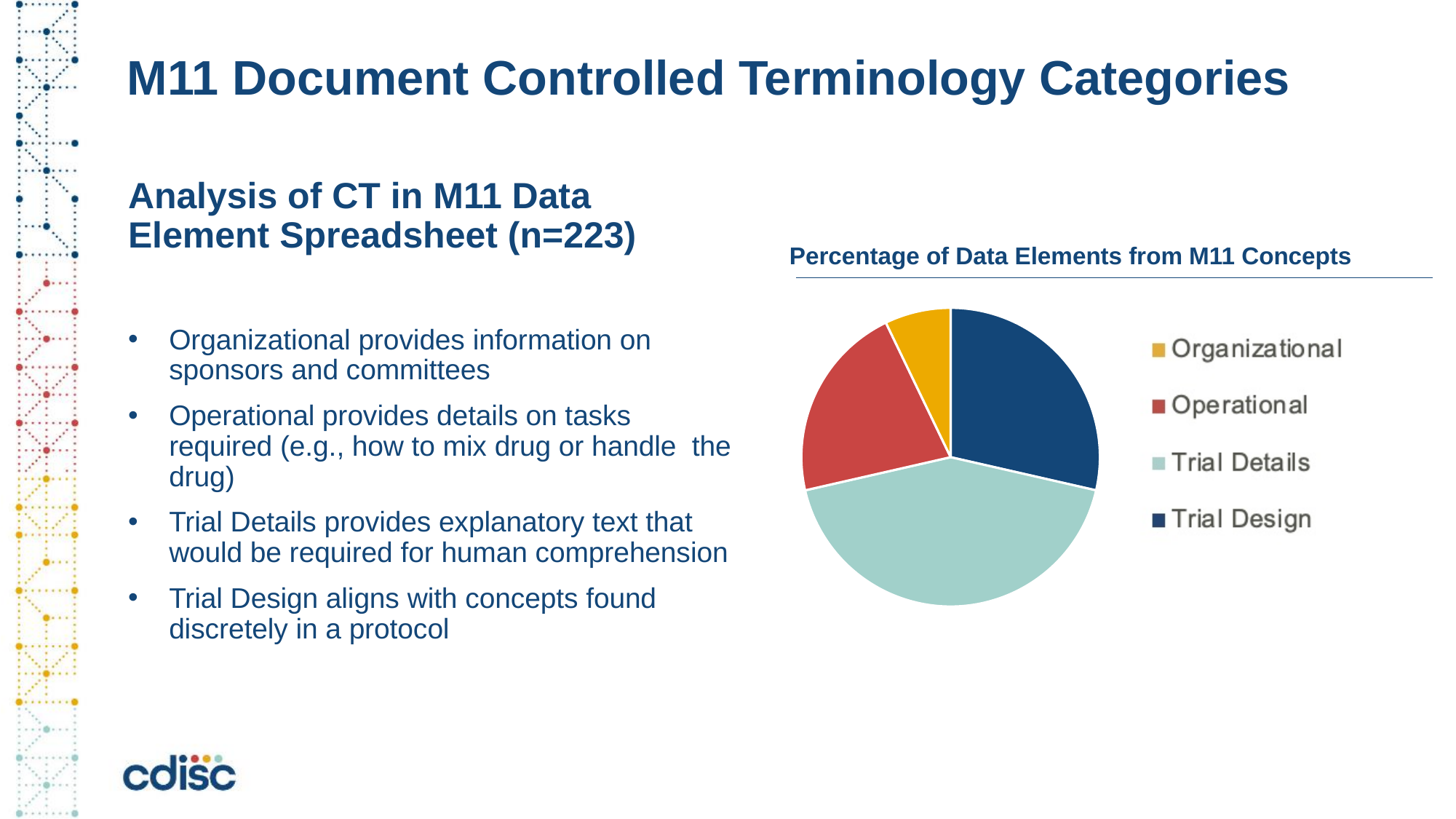
Which category has the largest slice of the pie? Trial Details How many entries does the chart's legend list? 4 What is the title of the chart? Percentage of Data Elements from M11 Concepts Which category is shown in yellow in the pie chart? Organizational Which slice is larger, Trial Details or Trial Design? Trial Details Which category has the smallest slice of the pie? Organizational Which slice is larger, Trial Design or Operational? Trial Design How many categories does the pie chart show? 4 Which slice is larger, Operational or Organizational? Operational What kind of chart is shown on the slide? Pie chart